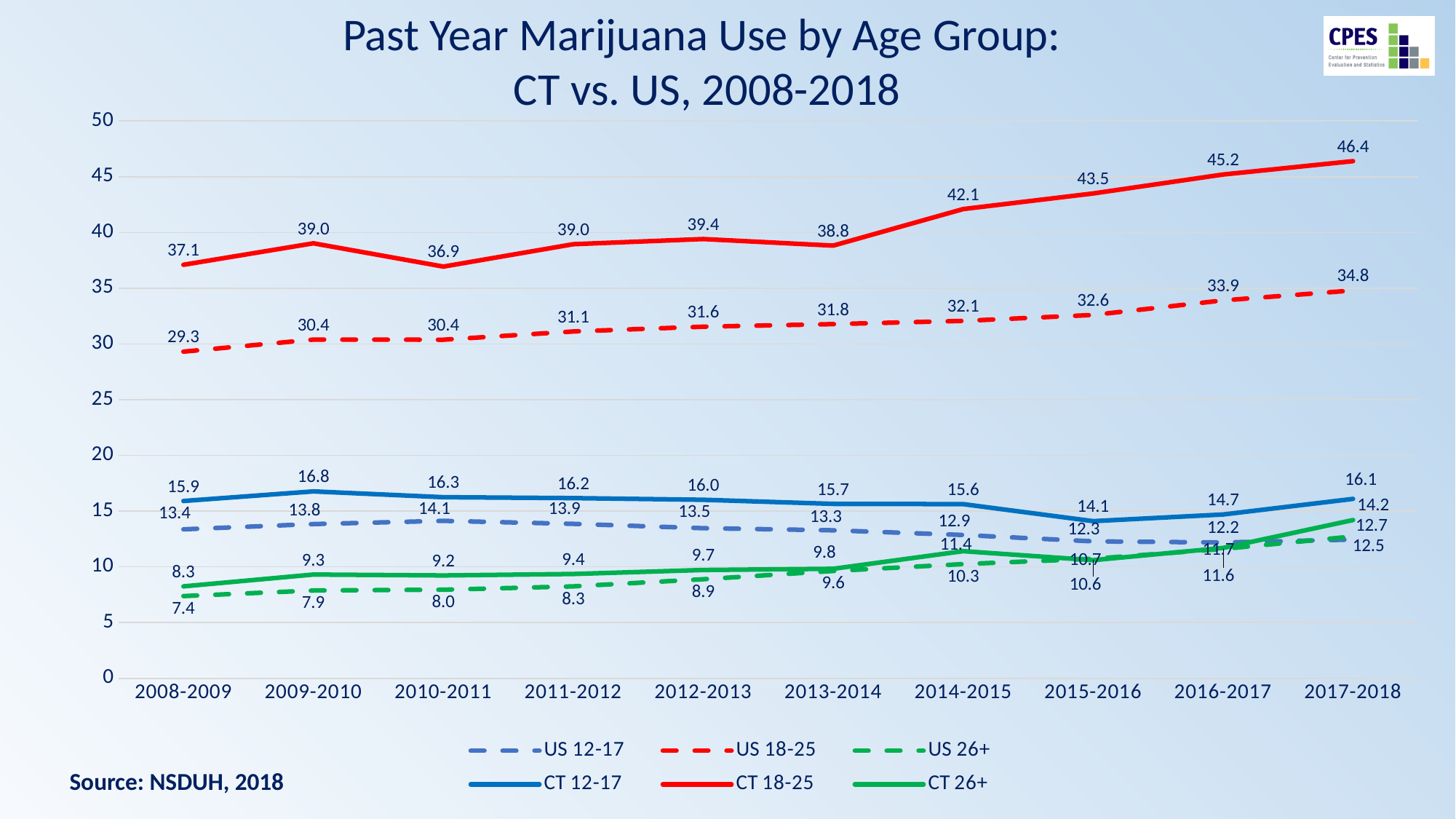
What is the difference between the CT 18-25 and US 18-25 values in 2017-2018? 11.6 What type of chart is shown on the slide? line chart How many time periods are shown on the x axis? 10 What is the value for US 18-25 in 2008-2009? 29.3 In which period is the CT 18-25 value lowest? 2010-2011 Does the US 18-25 series rise or fall from 2008-2009 to 2017-2018? rise What is the value for CT 12-17 in 2009-2010? 16.8 How many series does the legend list? 6 What is the source cited on the slide? NSDUH, 2018 In which period is the CT 12-17 value highest? 2009-2010 Which is larger in 2015-2016, CT 26+ or US 26+? US 26+ What is the value for CT 18-25 in 2017-2018? 46.4